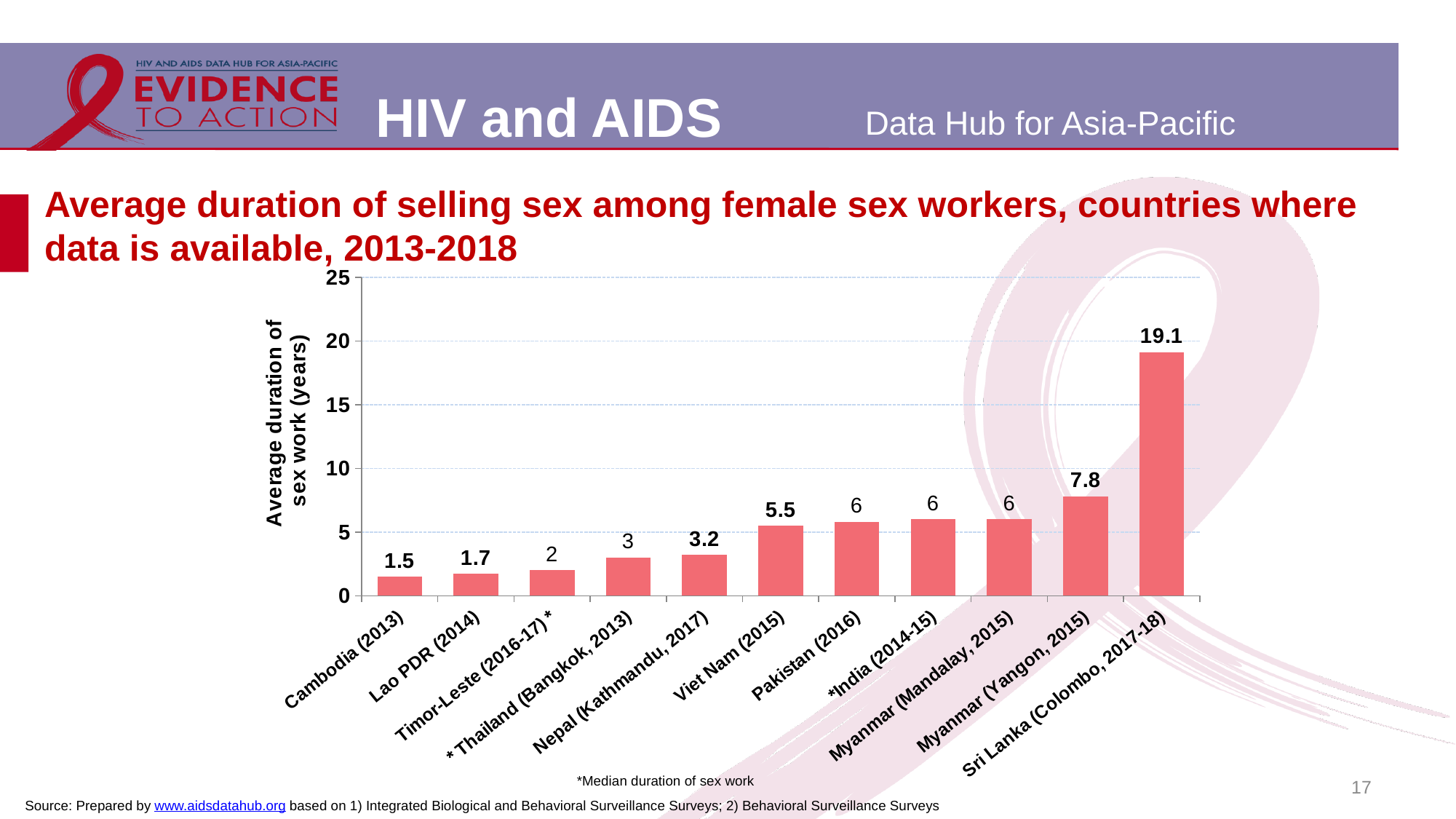
Which country has the highest average duration of selling sex? Sri Lanka (Colombo, 2017-18) Which country has the lowest average duration of selling sex? Cambodia (2013) What is the difference between the values for Viet Nam (2015) and Lao PDR (2014)? 3.8 Which is larger, the value for Viet Nam (2015) or the value for Thailand (Bangkok, 2013)? Viet Nam (2015) What is the difference between the values for Sri Lanka (Colombo, 2017-18) and Myanmar (Yangon, 2015)? 11.3 How many countries or sites are shown in the chart? 11 What is the value shown for Myanmar (Yangon, 2015)? 7.8 What is the average duration of selling sex for Sri Lanka (Colombo, 2017-18)? 19.1 What is the label of the vertical axis? Average duration of sex work (years) What is the value shown for Nepal (Kathmandu, 2017)? 3.2 What is the value shown for Cambodia (2013)? 1.5 What kind of chart is shown on the slide? Bar chart